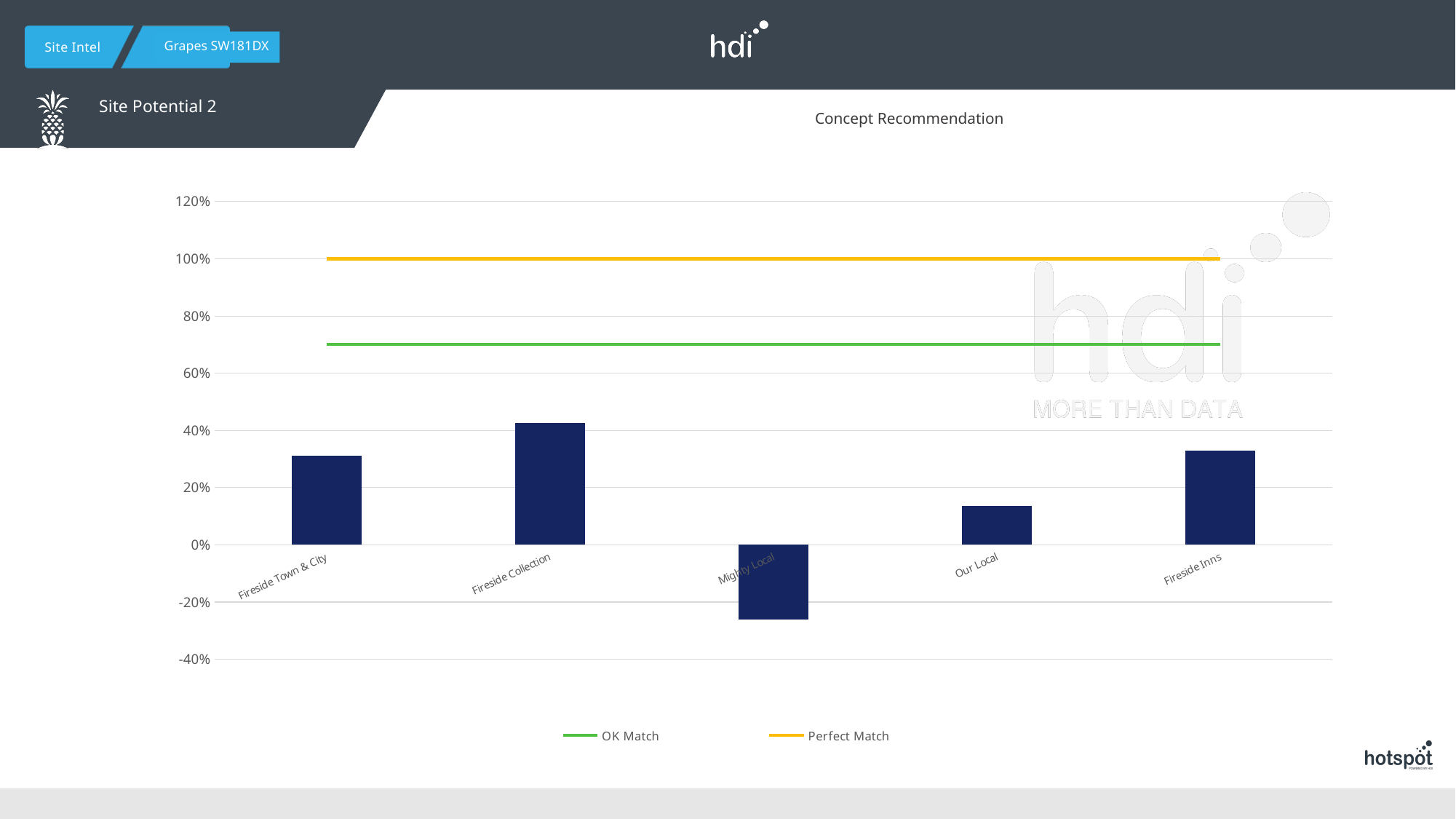
Is the value for Fireside Town & City greater or less than 20%? greater Is the value for Mighty Local greater or less than -20%? less Which is larger, the value for Fireside Collection or the value for Our Local? Fireside Collection At what level on the y axis does the Perfect Match line sit? 100% How many entries does the chart's legend list? 2 How many categories are plotted along the x axis of the chart? 5 Which category has the highest bar in the chart? Fireside Collection Which category has the lowest bar in the chart? Mighty Local What kind of chart is shown on the slide? Combination bar and line chart Is the value for Fireside Collection greater or less than 40%? greater What colour is the OK Match line in the chart? Green